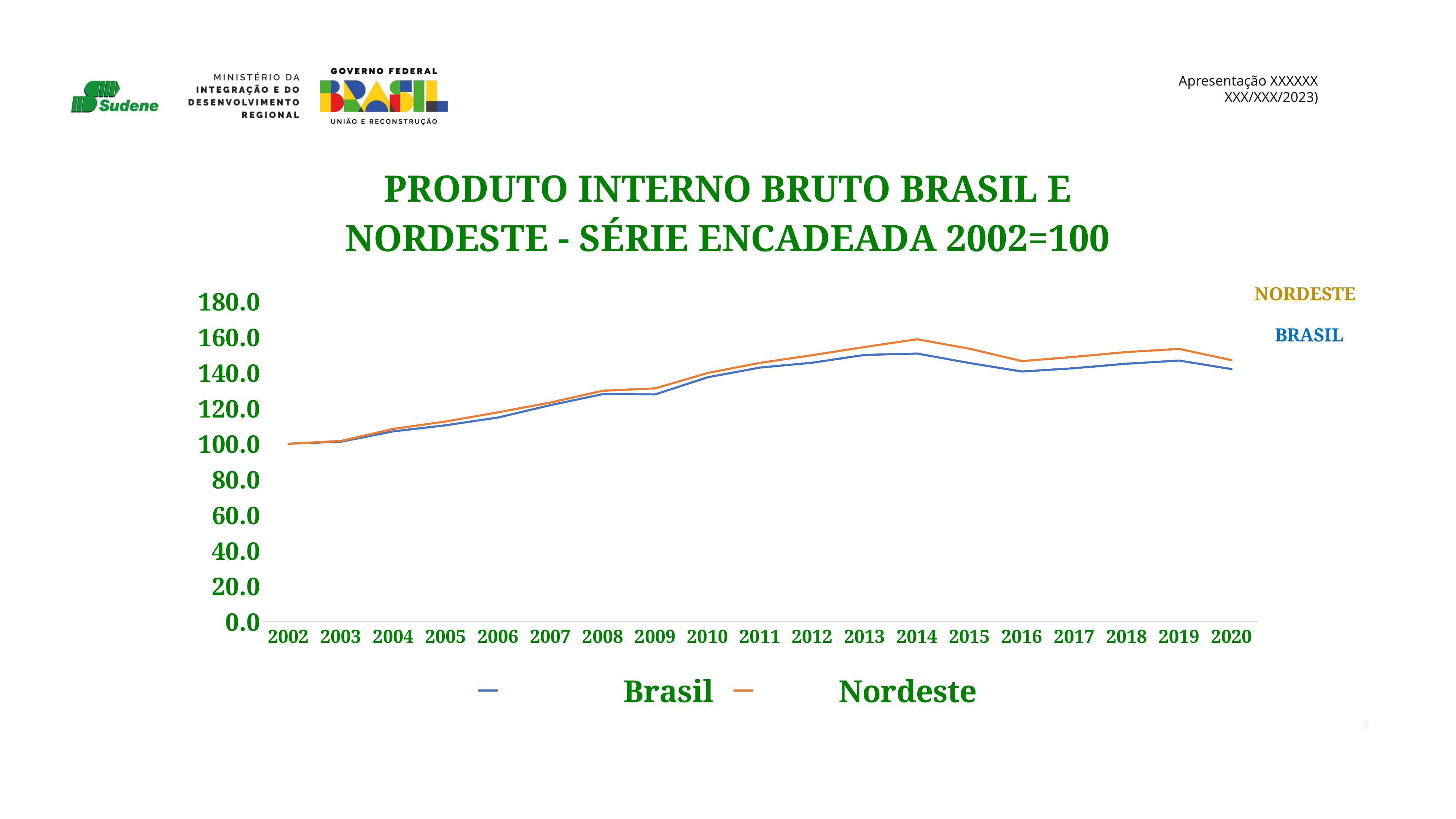
What kind of chart is shown on the slide? line chart How many series does the legend list? 2 Is the value for Brasil in 2006 greater or less than 120? less How many years are plotted along the x axis? 19 Is the value for Nordeste in 2014 greater or less than 140? greater What is the value for Nordeste in 2002? 100.0 In which year does the Nordeste series reach its highest value? 2014 In which year is the Brasil series at its lowest value? 2002 Is the value for Brasil in 2009 greater or less than 140? less What is the value for Brasil in 2002? 100.0 In 2014, which series has the higher value, Brasil or Nordeste? Nordeste Do the values for Brasil rise or fall between 2002 and 2014? rise